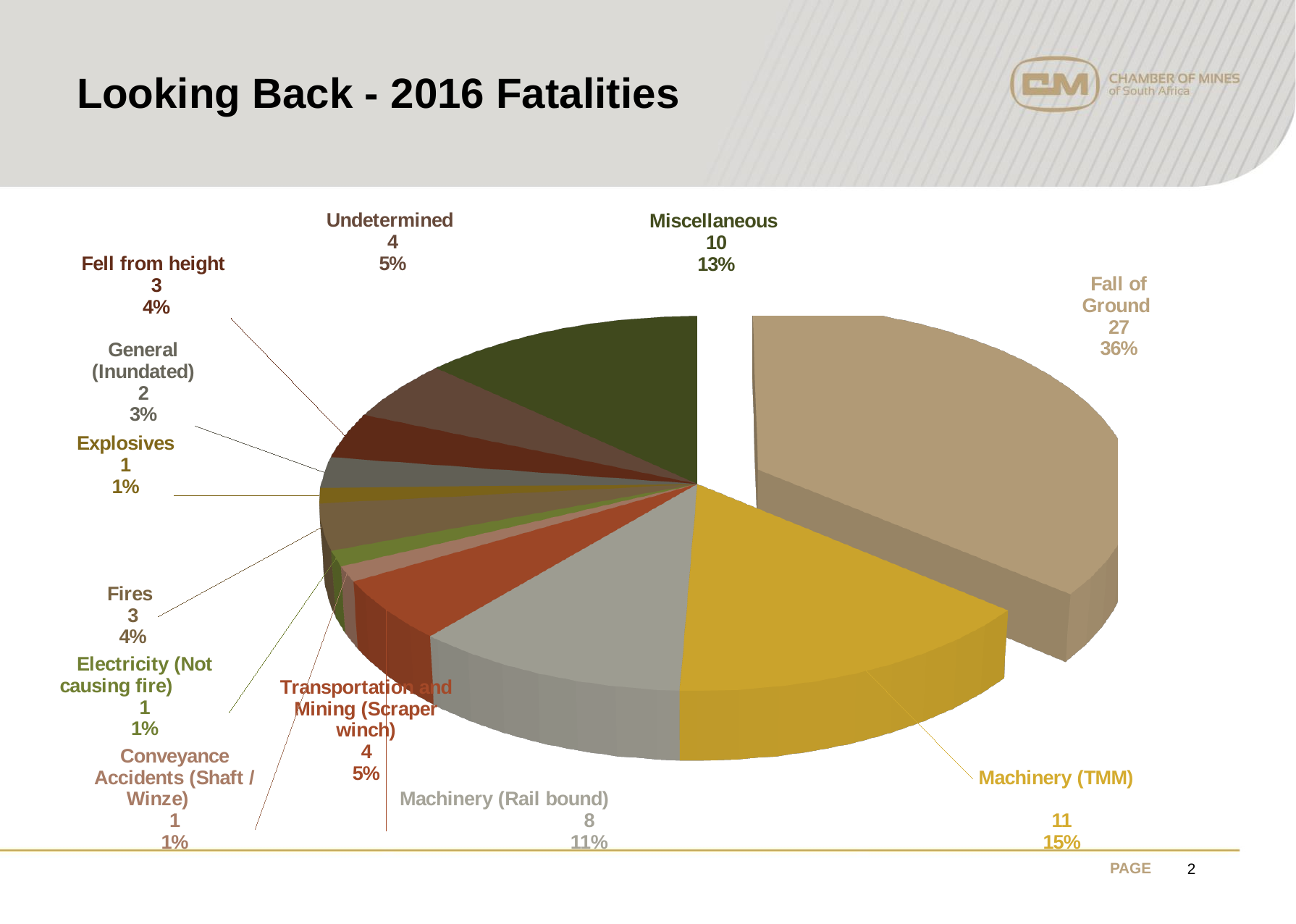
How many fatalities are attributed to Machinery (TMM)? 11 What percentage of fatalities is attributed to Miscellaneous? 13% Which has more fatalities, Machinery (Rail bound) or Miscellaneous? Miscellaneous How many fatalities are attributed to Undetermined? 4 What is the difference in fatalities between Fall of Ground and Machinery (TMM)? 16 How many categories are shown in the pie chart? 12 What type of chart is shown on the slide? Pie chart What share of the pie does Fall of Ground represent? 36% How many fatalities are attributed to Fall of Ground? 27 Which category has the largest slice of the pie? Fall of Ground What is the title of the slide containing the chart? Looking Back - 2016 Fatalities What is the percentage shown for Fires? 4%